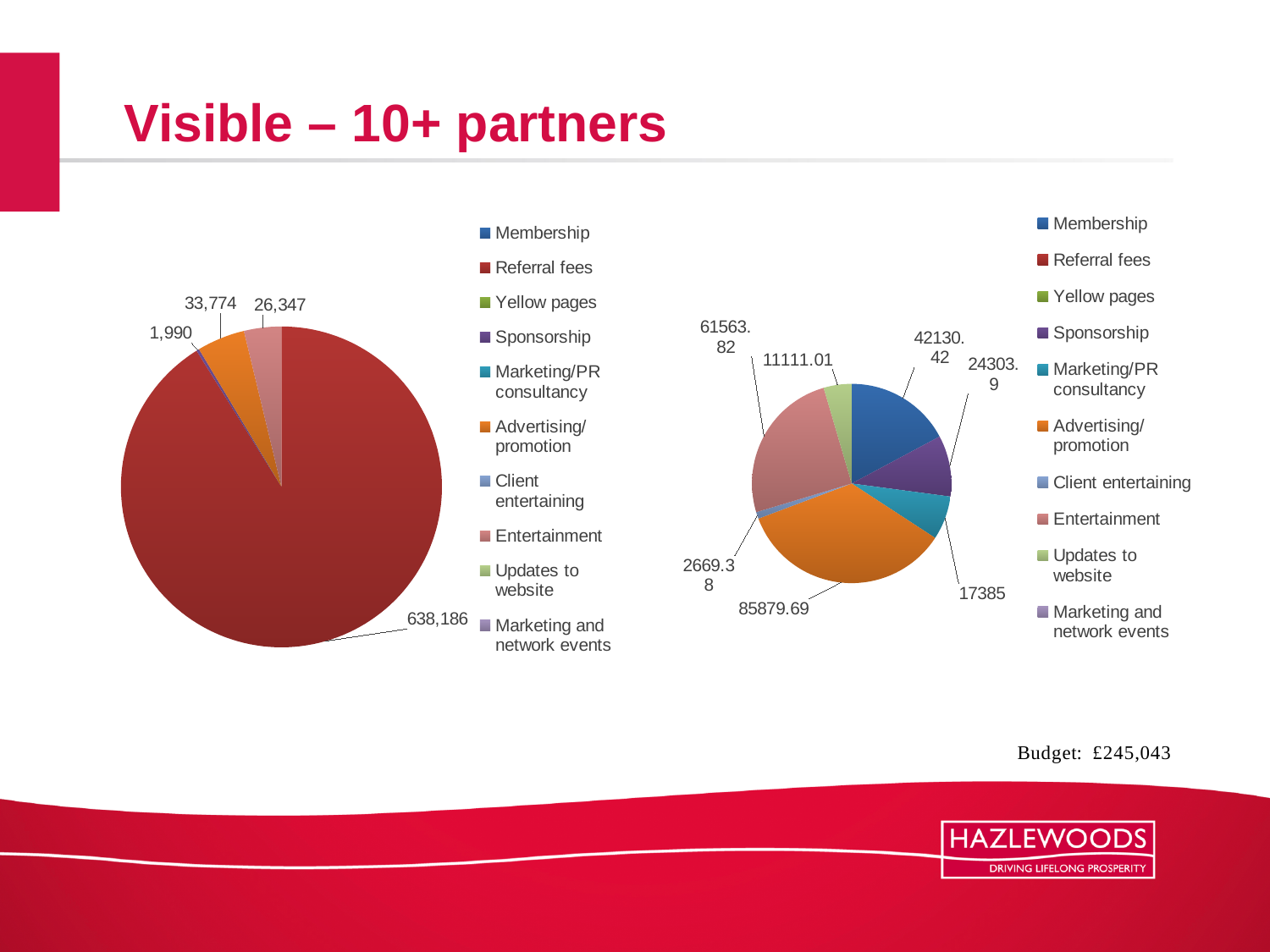
How many entries does the legend of the right pie chart list? 10 In the left pie chart, what is the difference between Advertising/promotion and Entertainment? 7,427 In the right pie chart, what is the difference between Advertising/promotion and Entertainment? 24315.87 In the right pie chart, which category has the smallest slice? Client entertaining In the right pie chart, what is the value for Updates to website? 11111.01 In the right pie chart, which is larger, Entertainment or Sponsorship? Entertainment In the left pie chart, what is the value for Advertising/promotion? 33,774 In the left pie chart, which category has the largest slice? Referral fees In the right pie chart, what is the value for Membership? 42130.42 In the left pie chart, what is the value for Referral fees? 638,186 In the right pie chart, what is the value for Advertising/promotion? 85879.69